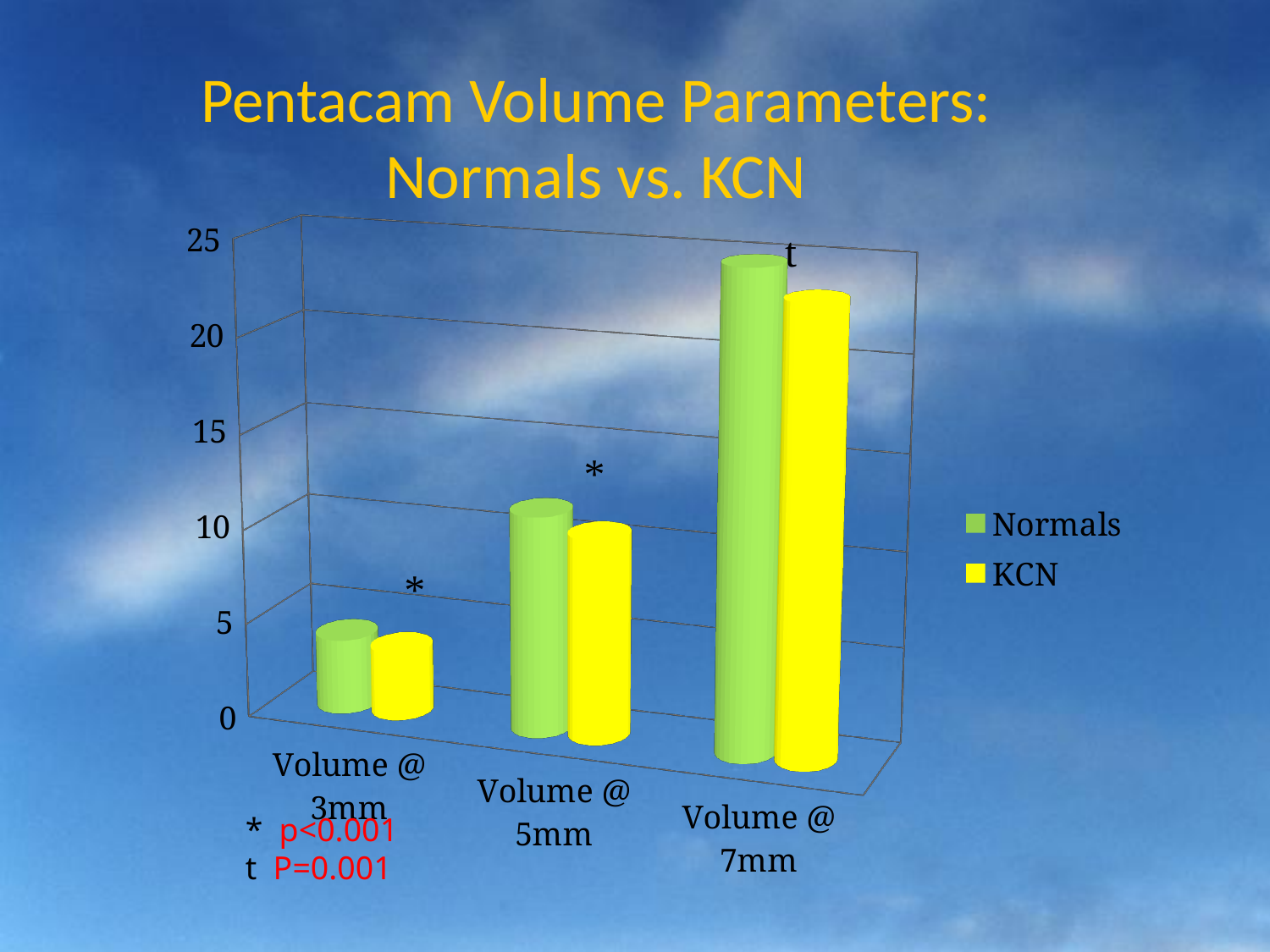
For Volume @ 7mm, which series has the larger value, Normals or KCN? Normals Do the values for the Normals series rise or fall from Volume @ 3mm to Volume @ 7mm? rise Is the KCN value for Volume @ 5mm greater or less than 15? less What is the title of the slide containing the chart? Pentacam Volume Parameters: Normals vs. KCN Which category has the lowest value for the KCN series? Volume @ 3mm What are the two series named in the legend? Normals and KCN How many series does the chart's legend list? 2 Is the Normals value for Volume @ 7mm greater or less than 20? greater How many categories are shown on the x axis of the chart? 3 Is the Normals value for Volume @ 3mm greater or less than 5? less Which category has the highest value for the Normals series? Volume @ 7mm What kind of chart is shown on the slide? bar chart